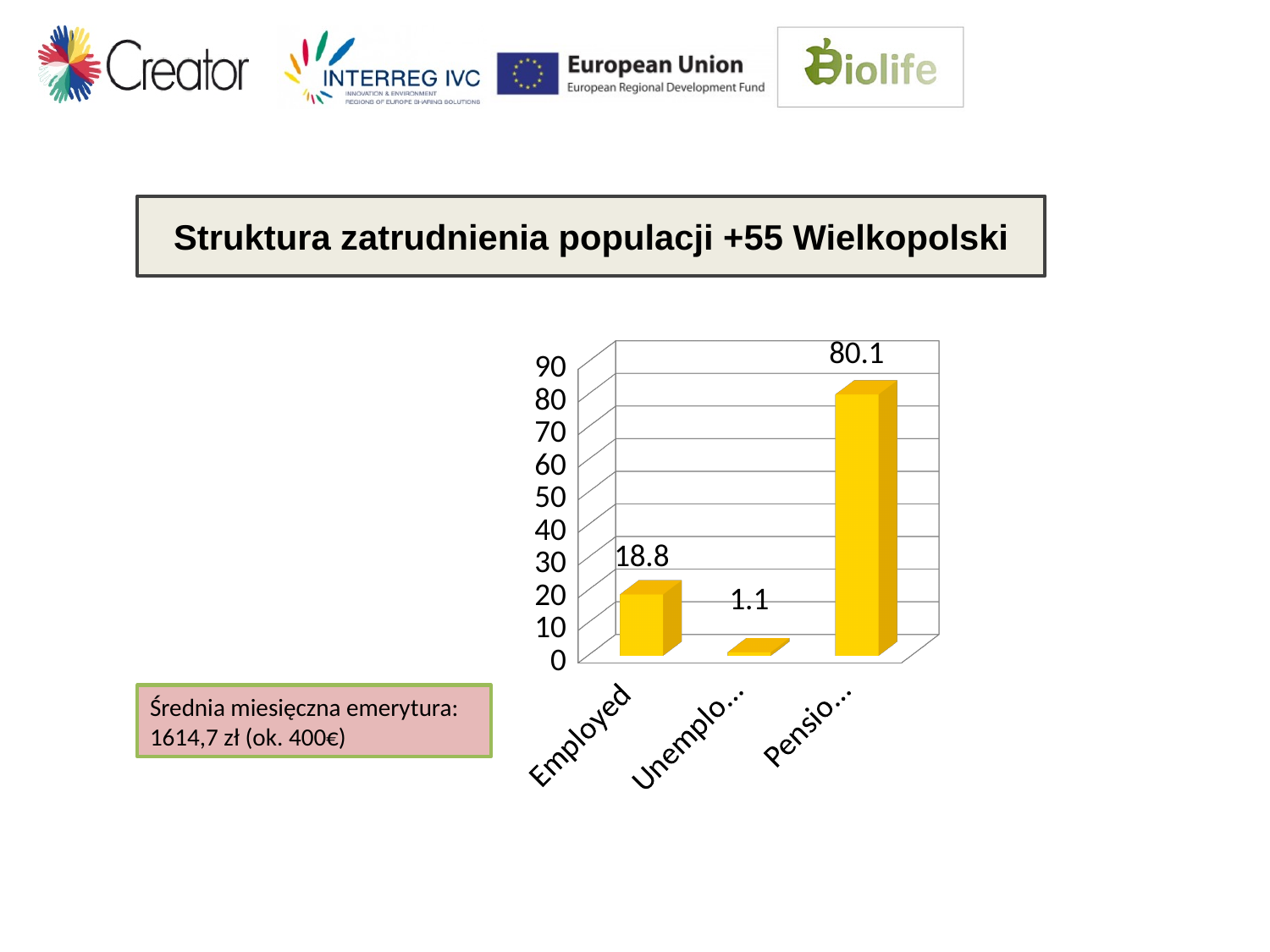
Which bar in the chart has the highest value? The third bar (Pensio...) What is the difference between the third bar (Pensio...) and the Employed bar? 61.3 Is the value for Employed greater or less than 20? less How many bars are shown in the chart? 3 What is the title shown above the chart on the slide? Struktura zatrudnienia populacji +55 Wielkopolski Which is larger, the value for Employed or the value of the third bar (Pensio...)? Pensio... What is the value of the third bar (labelled "Pensio...") in the chart? 80.1 Which bar in the chart has the lowest value? The second bar (Unemplo...) What is the value for Employed in the bar chart? 18.8 What is the difference between the Employed bar and the second bar (Unemplo...)? 17.7 What kind of chart is shown on the slide? Bar chart What is the value of the second bar (labelled "Unemplo...") in the chart? 1.1